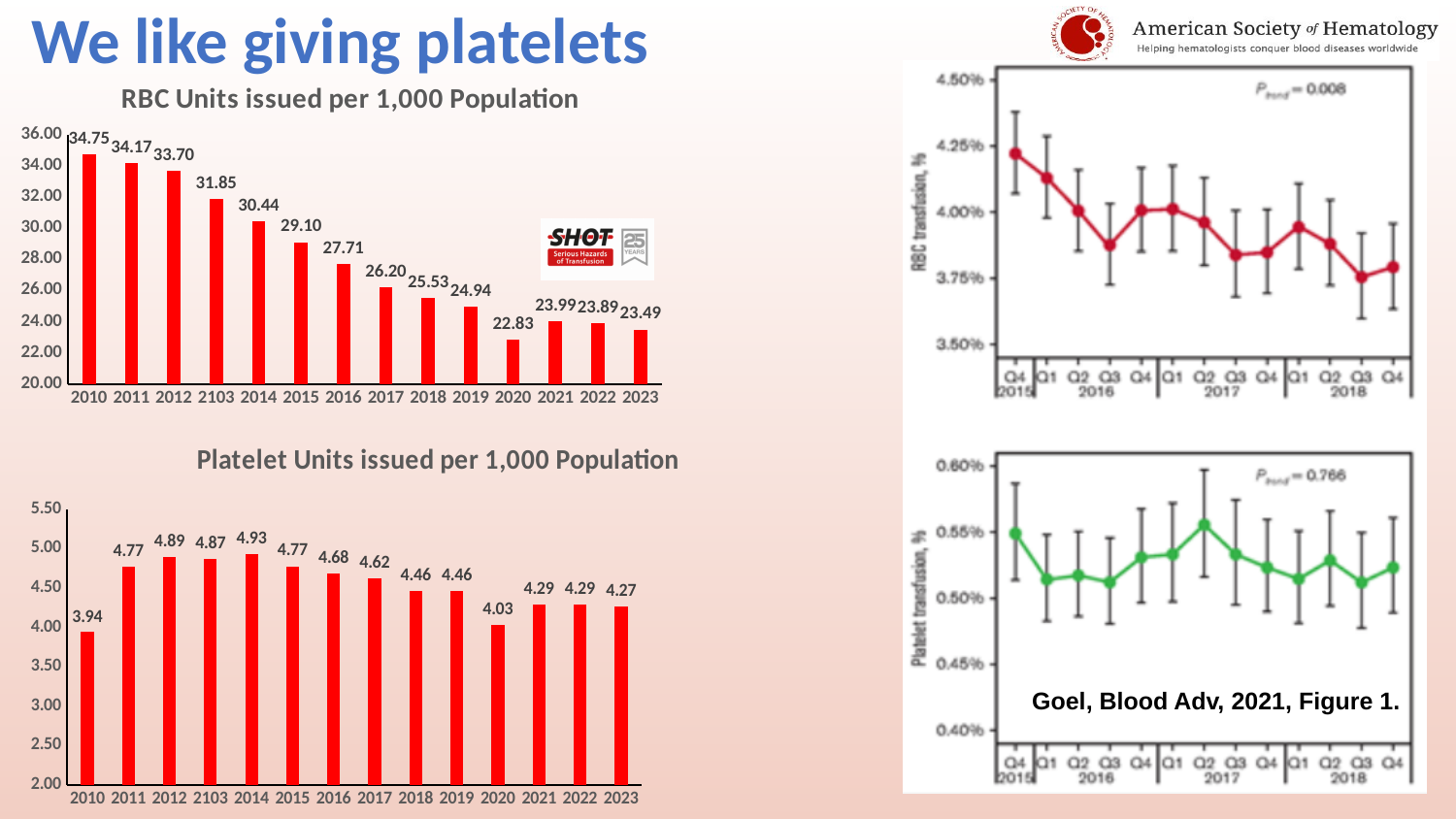
Do the values in the 'RBC Units issued per 1,000 Population' chart generally rise or fall from 2010 to 2023? fall What source citation is printed on the bottom-right 'Platelet transfusion, %' chart? Goel, Blood Adv, 2021, Figure 1. In the 'Platelet Units issued per 1,000 Population' chart, what is the difference between the 2014 value and the 2010 value? 0.99 In the top-right 'RBC transfusion, %' line chart, is the value for Q4 2015 greater or less than 4.00%? greater In the 'RBC Units issued per 1,000 Population' chart, what is the difference between the 2010 value and the 2023 value? 11.26 In the 'Platelet Units issued per 1,000 Population' chart, which year has the highest value? 2014 In the 'Platelet Units issued per 1,000 Population' chart, which is larger, the value for 2012 or the value for 2022? 2012 In the 'RBC Units issued per 1,000 Population' chart, what is the value for 2010? 34.75 In the 'Platelet Units issued per 1,000 Population' chart, what is the value for 2020? 4.03 What kind of chart is the 'Platelet Units issued per 1,000 Population' chart? bar chart How many bars are plotted in the 'RBC Units issued per 1,000 Population' chart? 14 In the 'RBC Units issued per 1,000 Population' chart, which year has the lowest value? 2020